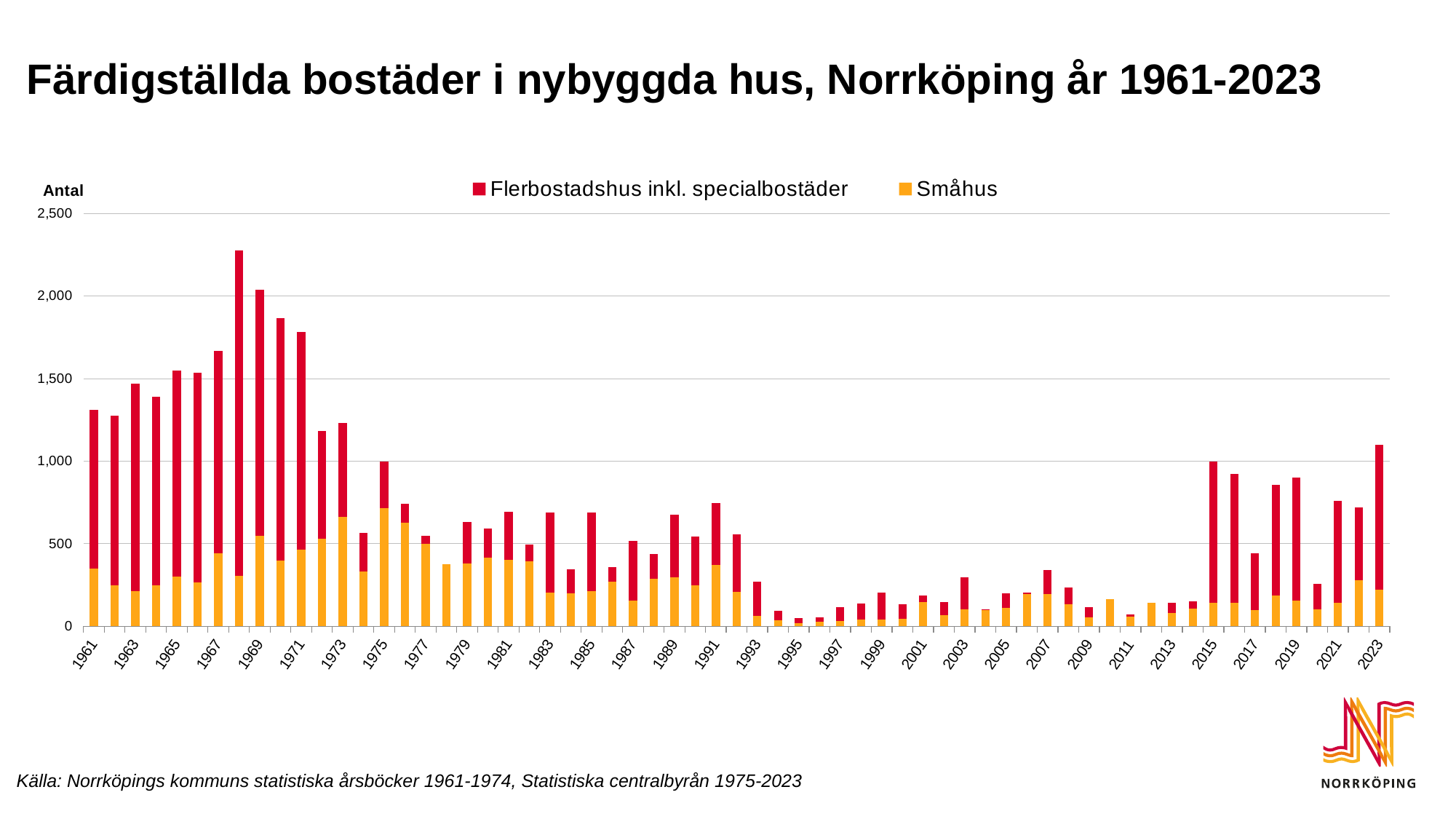
What are the two series named in the legend? Flerbostadshus inkl. specialbostäder and Småhus How many years (bars) are plotted on the x axis? 63 Between 1968 and 1978, do the total values generally rise or fall? fall Is the total value for 1970 greater or less than 1,500? greater How many series does the legend list? 2 Which year has the larger total, 1968 or 1969? 1968 What is the title of the chart? Färdigställda bostäder i nybyggda hus, Norrköping år 1961-2023 Is the total value for 2023 greater or less than 1,000? greater Which year has the highest total number of completed dwellings? 1968 Is the total value for 1968 greater or less than 2,000? greater What kind of chart is shown on the slide? Stacked bar chart